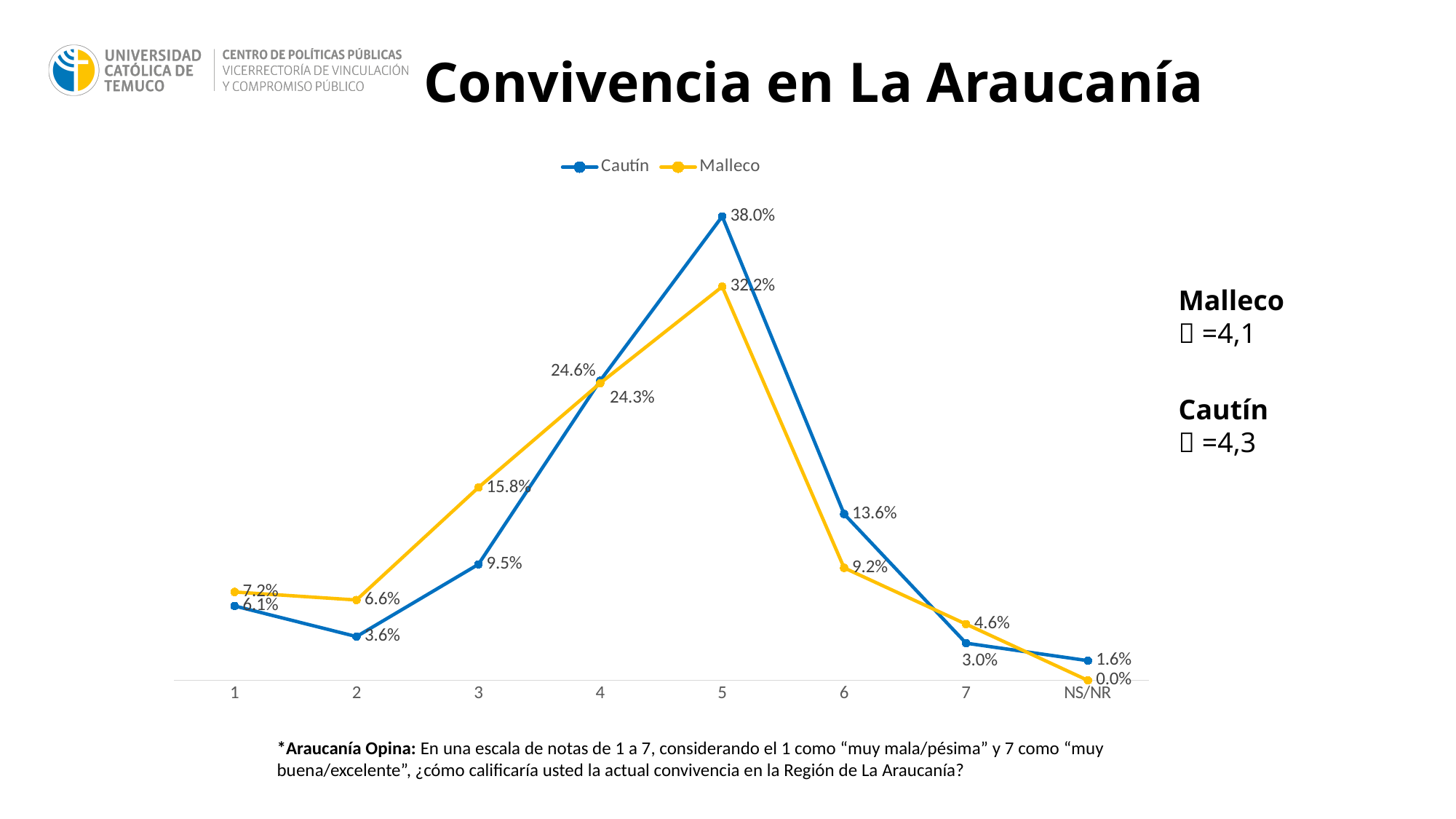
How many series does the legend list? 2 What kind of chart is shown on the slide? Line chart What is the value for Cautín at rating 5? 38.0% How many categories are shown on the x axis? 8 At rating 6, which series has the larger value, Cautín or Malleco? Cautín At which rating does the Cautín series reach its highest value? 5 What is the difference between Cautín and Malleco at rating 5? 5.8 percentage points What is the title of the chart on the slide? Convivencia en La Araucanía What is the value for Malleco at rating 3? 15.8% At which category does the Malleco series have its lowest value? NS/NR What is the value for Malleco at rating 5? 32.2% What is the value for Cautín at NS/NR? 1.6%